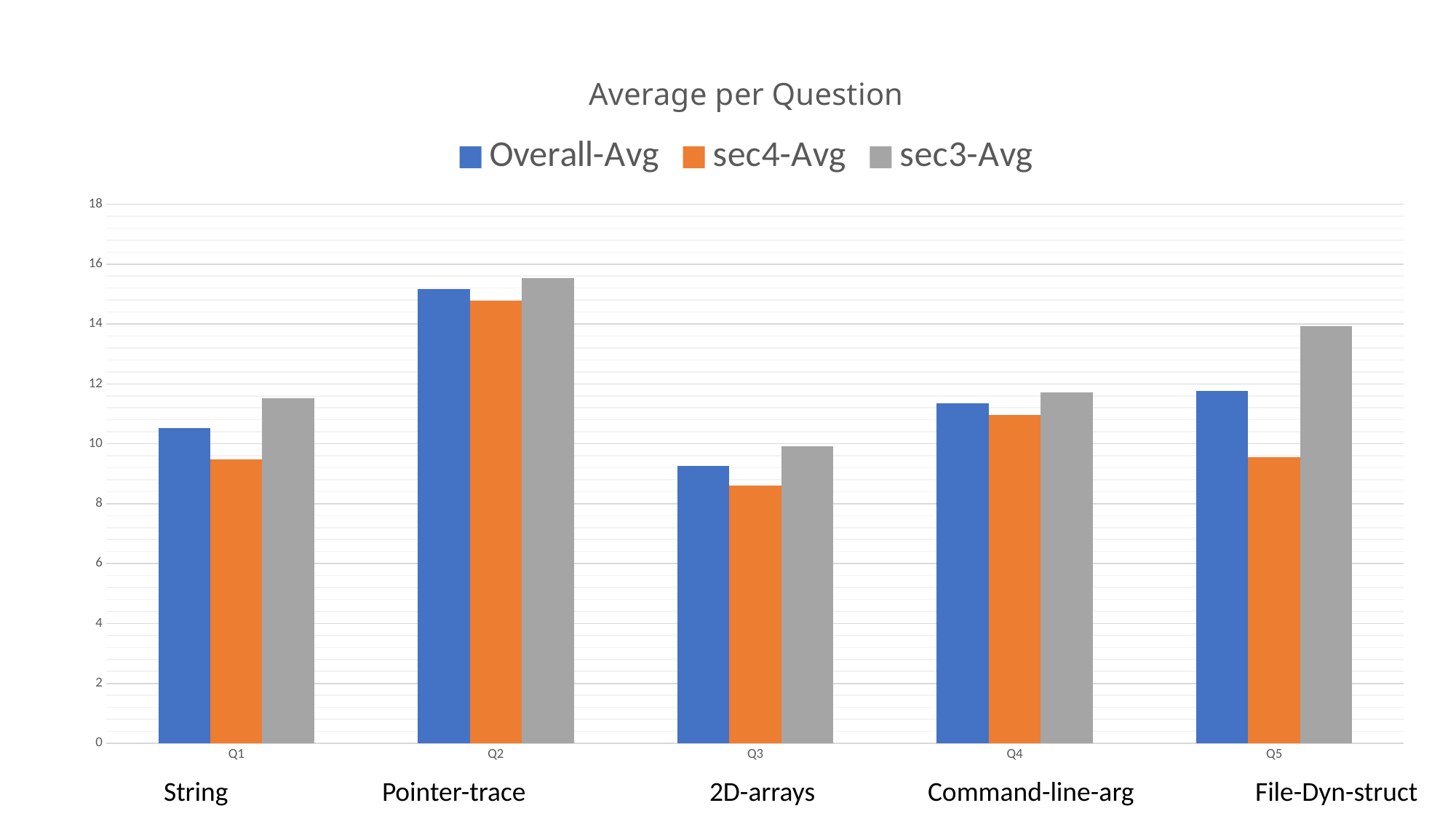
Which question has the lowest sec4-Avg value? Q3 Which question has the lowest Overall-Avg value? Q3 What is the title of the chart? Average per Question What type of chart is shown on the slide? bar chart Which question has the highest sec3-Avg value? Q2 Which question has the highest Overall-Avg value? Q2 Is the sec3-Avg value for Q5 greater or less than 12? greater How many series does the legend list? 3 Is the sec4-Avg value for Q3 greater or less than 10? less How many question categories are shown on the x axis? 5 For Q5, which is larger: the sec3-Avg value or the sec4-Avg value? sec3-Avg Is the Overall-Avg value for Q2 greater or less than 14? greater